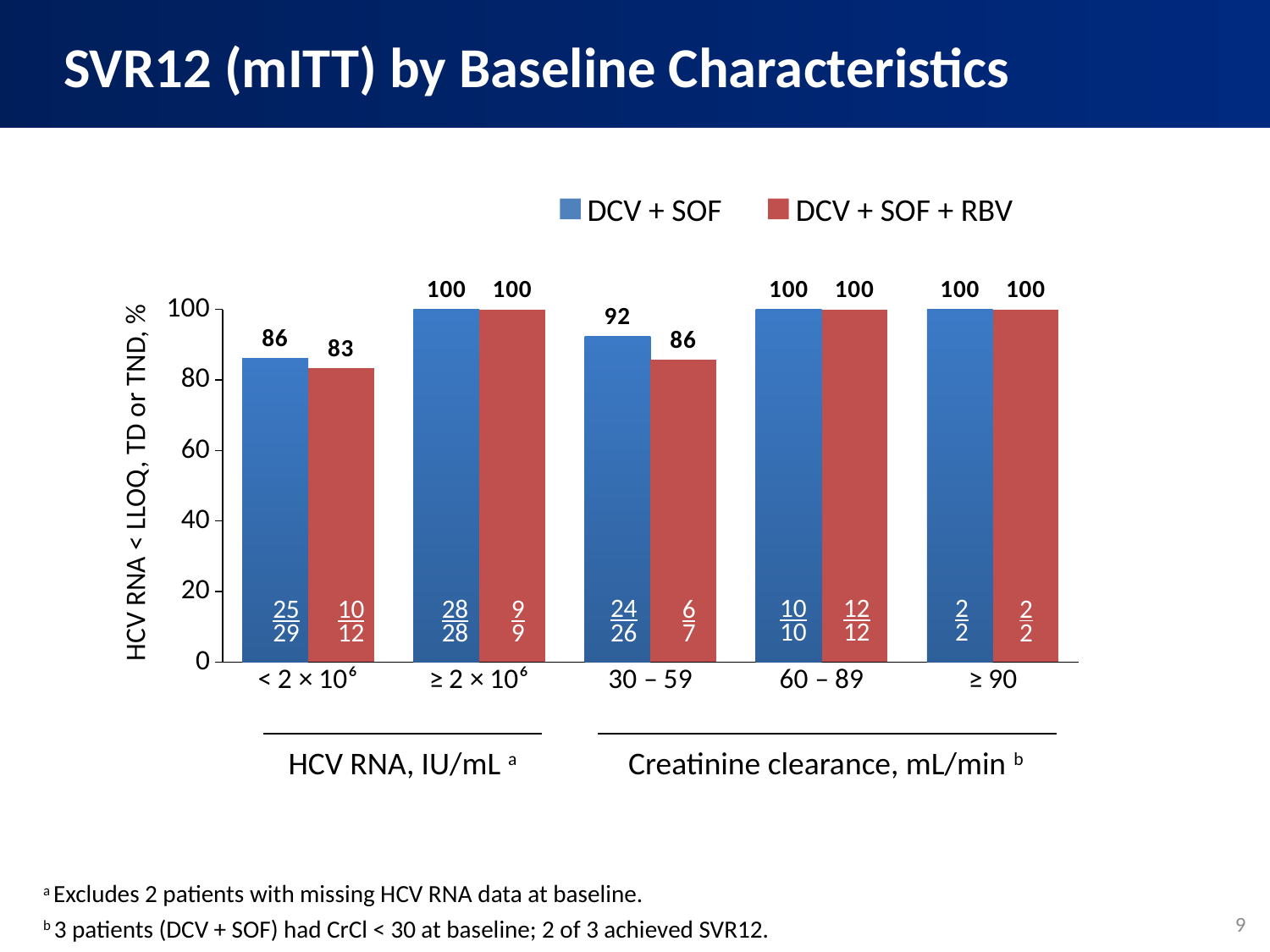
Which category has the lowest SVR12 value for DCV + SOF + RBV? < 2 × 10⁶ How many series does the legend list? 2 What is the label of the y axis? HCV RNA < LLOQ, TD or TND, % In the < 2 × 10⁶ HCV RNA category, which series has the larger value, DCV + SOF or DCV + SOF + RBV? DCV + SOF What is the SVR12 value for DCV + SOF + RBV in the 30 – 59 creatinine clearance category? 86 What is the SVR12 value for DCV + SOF + RBV in the < 2 × 10⁶ HCV RNA category? 83 How many categories are shown on the x axis? 5 What kind of chart is shown on the slide? Bar chart What is the SVR12 value for DCV + SOF in the 30 – 59 creatinine clearance category? 92 What is the SVR12 value for DCV + SOF in the < 2 × 10⁶ HCV RNA category? 86 What is the SVR12 value for DCV + SOF in the ≥ 2 × 10⁶ HCV RNA category? 100 What is the difference between the DCV + SOF and DCV + SOF + RBV values in the 30 – 59 creatinine clearance category? 6